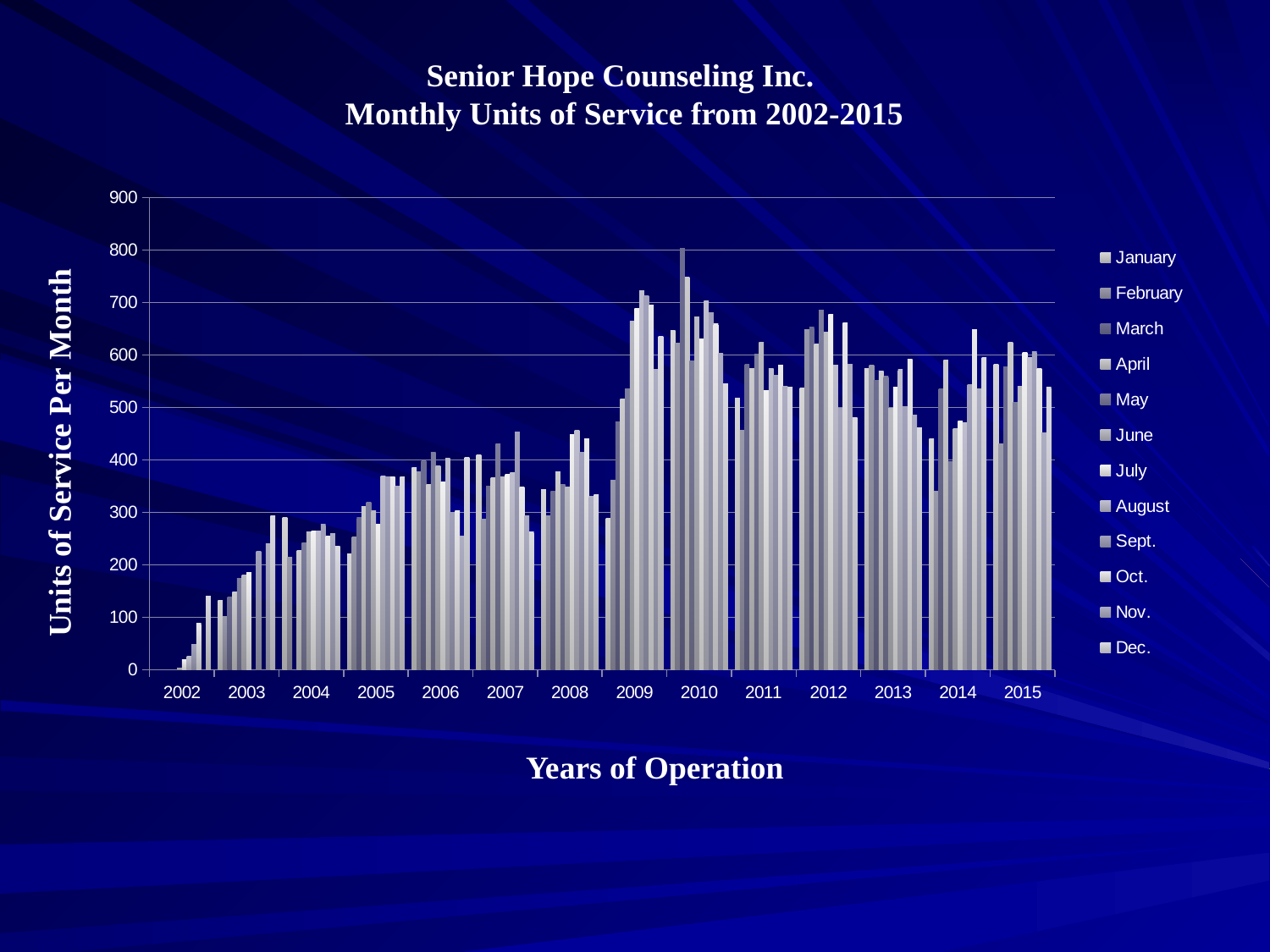
How many series does the legend list? 12 Are all the bars for 2015 greater or less than 700? less Do the monthly units of service generally rise or fall from 2002 to 2009? rise What kind of chart is shown on the slide? Bar chart How many years are shown along the x axis of the chart? 14 Which year contains the tallest bar in the chart? 2010 Are all the bars for 2005 greater or less than 500? less Is the tallest bar in 2010 greater or less than 700? greater What is the label on the vertical axis? Units of Service Per Month Which year has the lowest bars in the chart? 2002 What is the title of the chart? Senior Hope Counseling Inc. Monthly Units of Service from 2002-2015